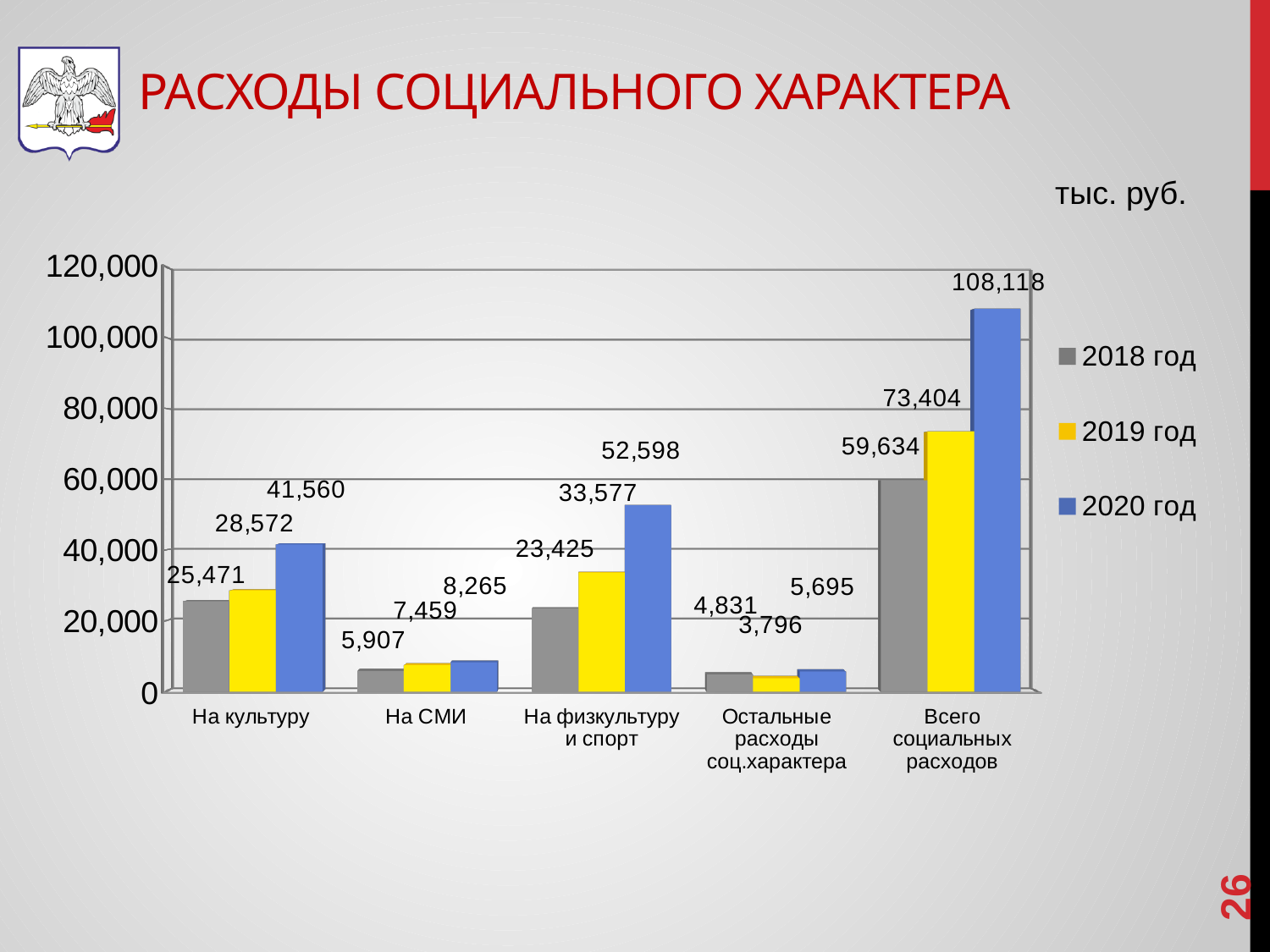
Which category has the highest value for 2018 год? Всего социальных расходов Which category has the lowest value for 2019 год? Остальные расходы соц.характера What is the difference between the 2020 год and 2019 год values for На культуру? 12,988 Which is larger for Остальные расходы соц.характера: the 2018 год value or the 2019 год value? 2018 год How many series does the legend list? 3 What type of chart is shown on the slide? bar chart What unit is indicated above the chart? тыс. руб. What is the value for 2020 год in the category Всего социальных расходов? 108,118 What is the value for 2019 год in the category На СМИ? 7,459 Do the values for На физкультуру и спорт rise or fall from 2018 год to 2020 год? rise How many categories are shown on the x axis? 5 What is the value for 2018 год in the category На физкультуру и спорт? 23,425